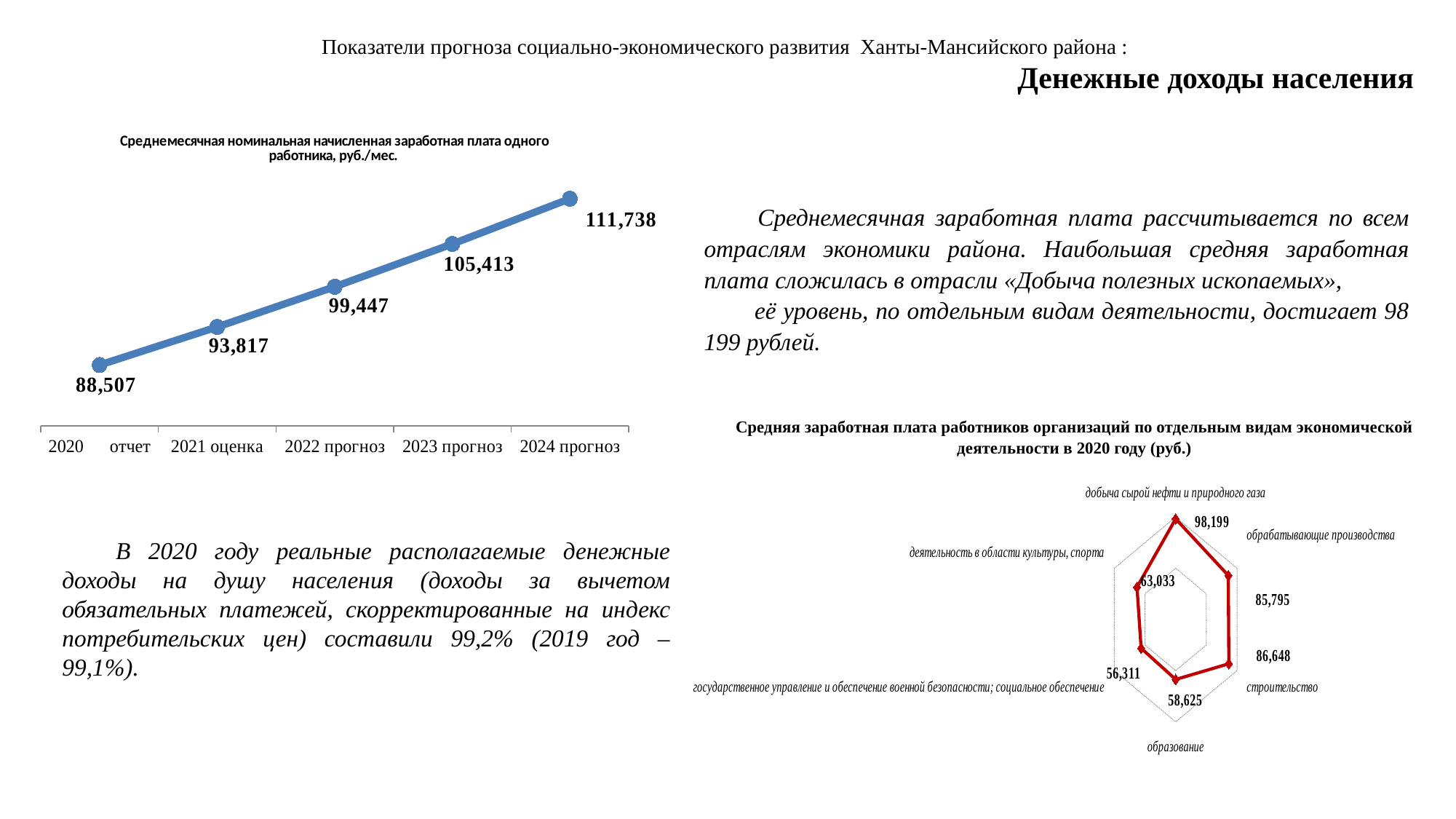
On the line chart on the left, what is the difference between the 2024 прогноз and 2020 отчет values? 23,231 On the line chart on the left, what is the average monthly nominal wage for 2020 отчет? 88,507 On the line chart on the left, how many data points are plotted? 5 On the radar chart on the right, what is the difference between the values for строительство and обрабатывающие производства? 853 On the radar chart on the right, which type of economic activity has the lowest average wage? государственное управление и обеспечение военной безопасности; социальное обеспечение On the radar chart on the right, which type of economic activity has the highest average wage? добыча сырой нефти и природного газа What type of chart is the chart on the left of the slide? line chart On the line chart on the left, do the values rise or fall from 2020 to 2024? rise On the line chart on the left, what is the value for 2024 прогноз? 111,738 On the line chart on the left, what is the value for 2022 прогноз? 99,447 On the radar chart on the right, what is the average wage for добыча сырой нефти и природного газа? 98,199 On the radar chart on the right, how many types of economic activity are shown? 6